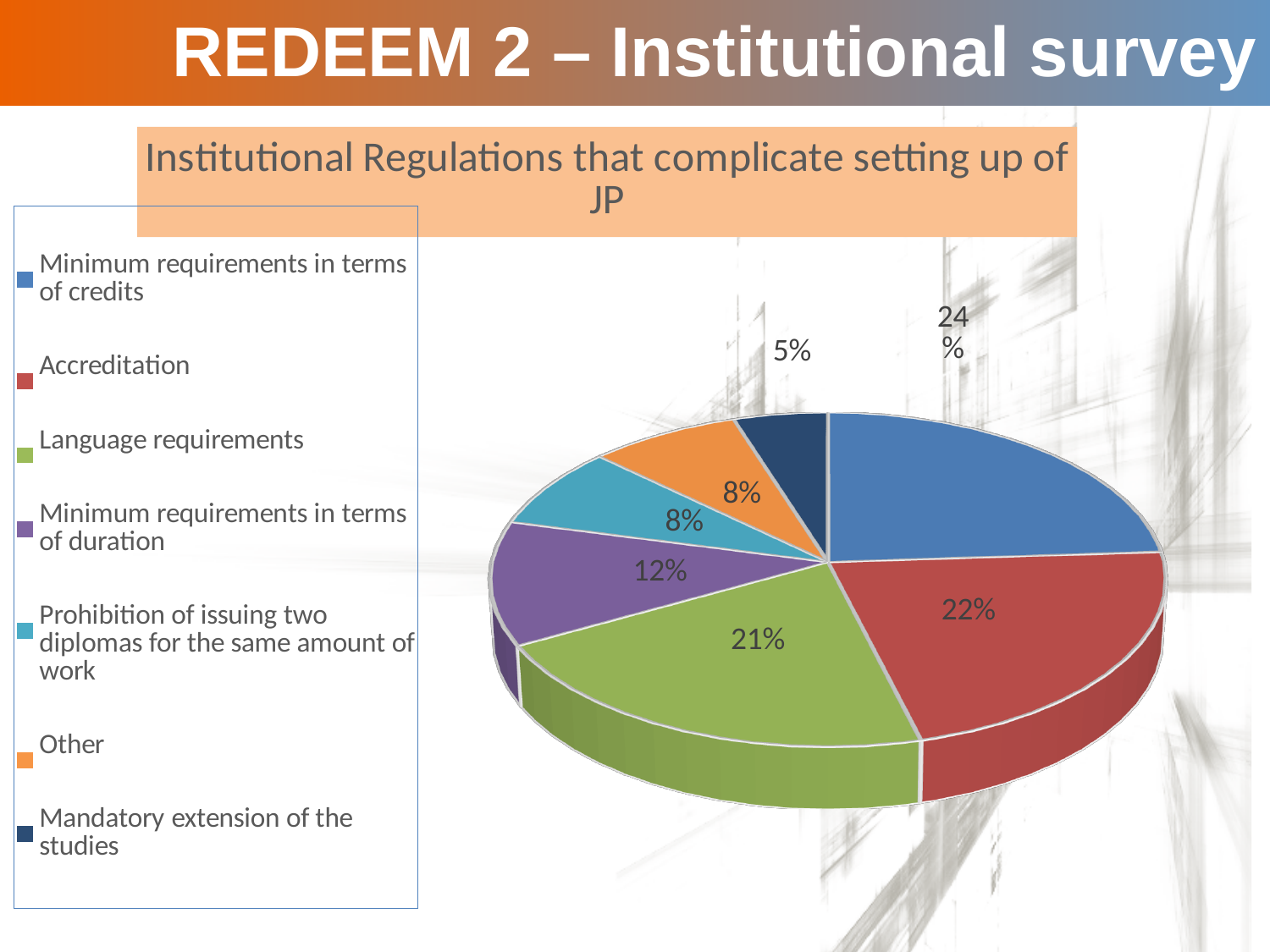
What is the title of the chart? Institutional Regulations that complicate setting up of JP What share of the pie is Accreditation? 22% Which category has the largest share of the pie? Minimum requirements in terms of credits What share of the pie is Language requirements? 21% What is the difference in percentage points between Accreditation and Minimum requirements in terms of duration? 10 What share of the pie is Minimum requirements in terms of credits? 24% What share of the pie is Mandatory extension of the studies? 5% How many categories does the legend list? 7 What kind of chart is shown on the slide? pie chart Which is larger, the share for Other or the share for Mandatory extension of the studies? Other Which category has the smallest share of the pie? Mandatory extension of the studies What share of the pie is Minimum requirements in terms of duration? 12%